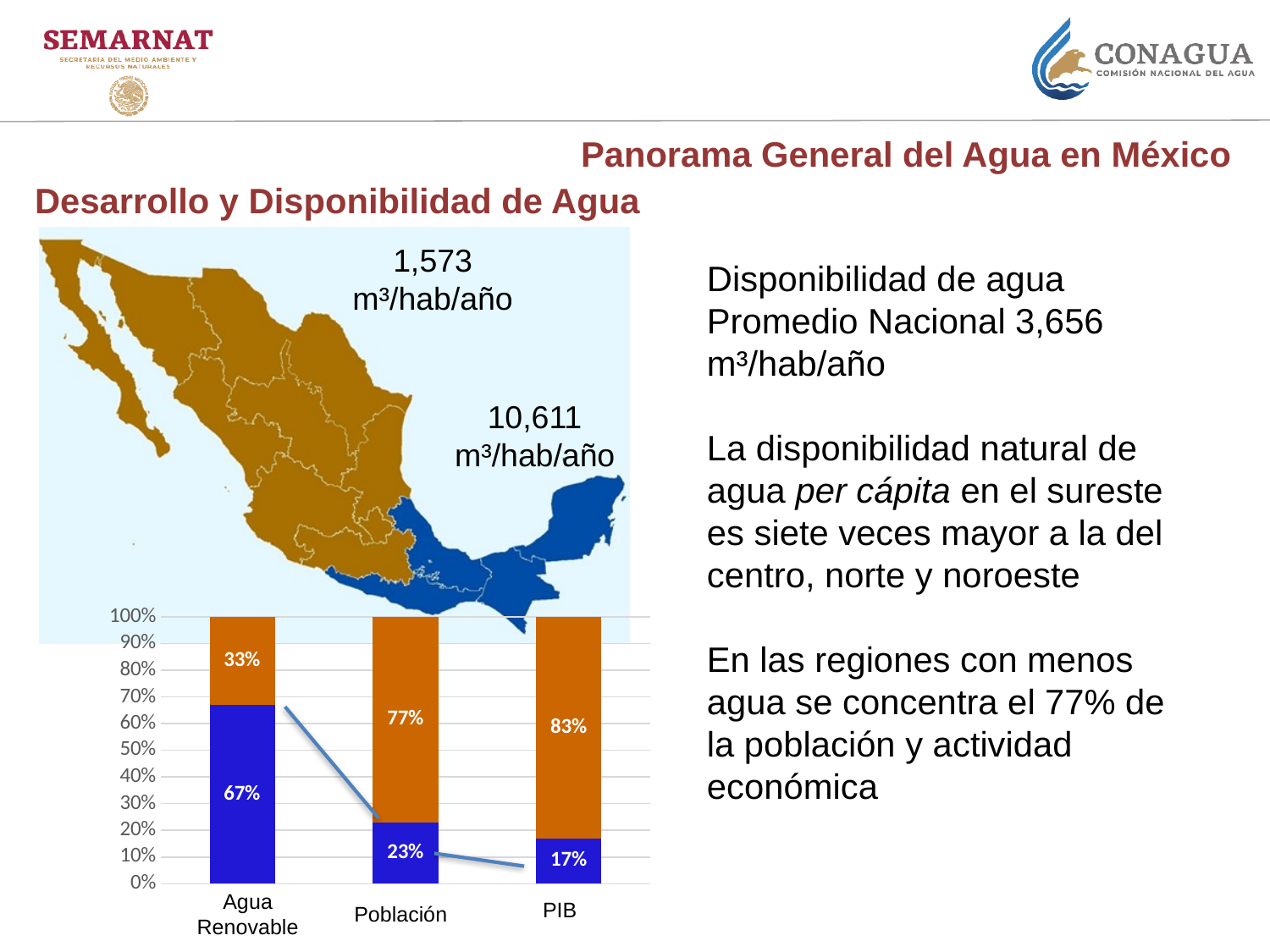
What kind of chart is shown at the bottom left of the slide? stacked bar chart What is the value of the blue segment for PIB? 17% What is the difference between the blue segment for Agua Renovable and the blue segment for Población? 44% Which category has the smallest blue segment? PIB What is the value of the orange segment for Agua Renovable? 33% Which is larger, the orange segment for PIB or the orange segment for Población? PIB Do the blue segment values rise or fall from Agua Renovable to PIB along the x axis? fall What is the total of the stacked bar for Población? 100% What is the value of the blue segment for Agua Renovable? 67% How many categories are shown on the x axis of the bar chart? 3 Which category has the largest blue segment? Agua Renovable What is the value of the orange segment for Población? 77%